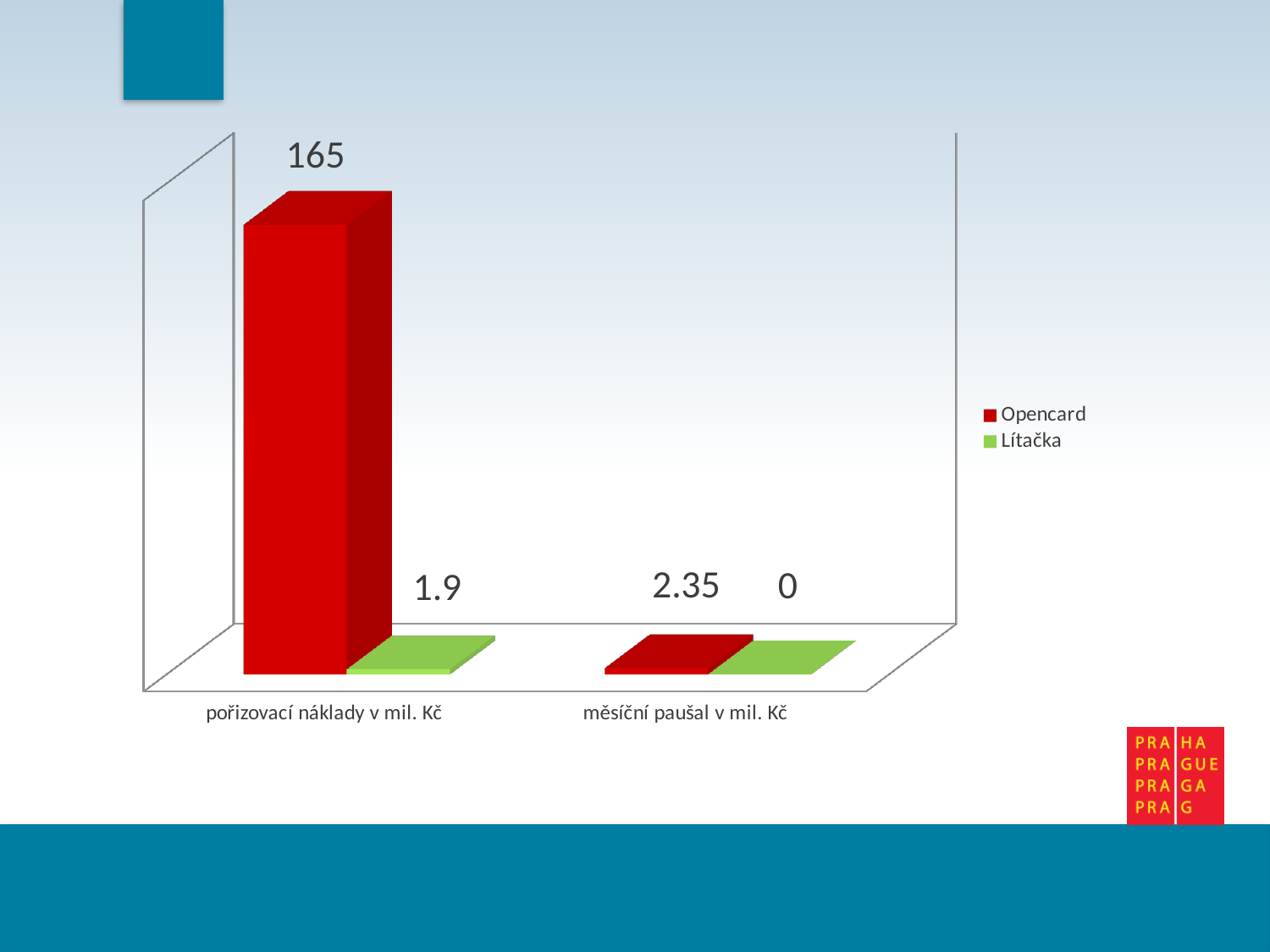
What kind of chart is shown on the slide? Bar chart How many series does the legend list? 2 How many categories are shown on the x axis? 2 What is the value for Opencard in the 'měsíční paušal v mil. Kč' category? 2.35 Which series has the lower value in the 'měsíční paušal v mil. Kč' category? Lítačka What is the value for Lítačka in the 'pořizovací náklady v mil. Kč' category? 1.9 What is the value for Opencard in the 'pořizovací náklady v mil. Kč' category? 165 Which bar has the highest value in the chart? Opencard, pořizovací náklady v mil. Kč What is the value for Lítačka in the 'měsíční paušal v mil. Kč' category? 0 What is the difference between the Opencard and Lítačka values for 'pořizovací náklady v mil. Kč'? 163.1 Which series has the higher value in the 'pořizovací náklady v mil. Kč' category? Opencard What is the difference between the Opencard and Lítačka values for 'měsíční paušal v mil. Kč'? 2.35